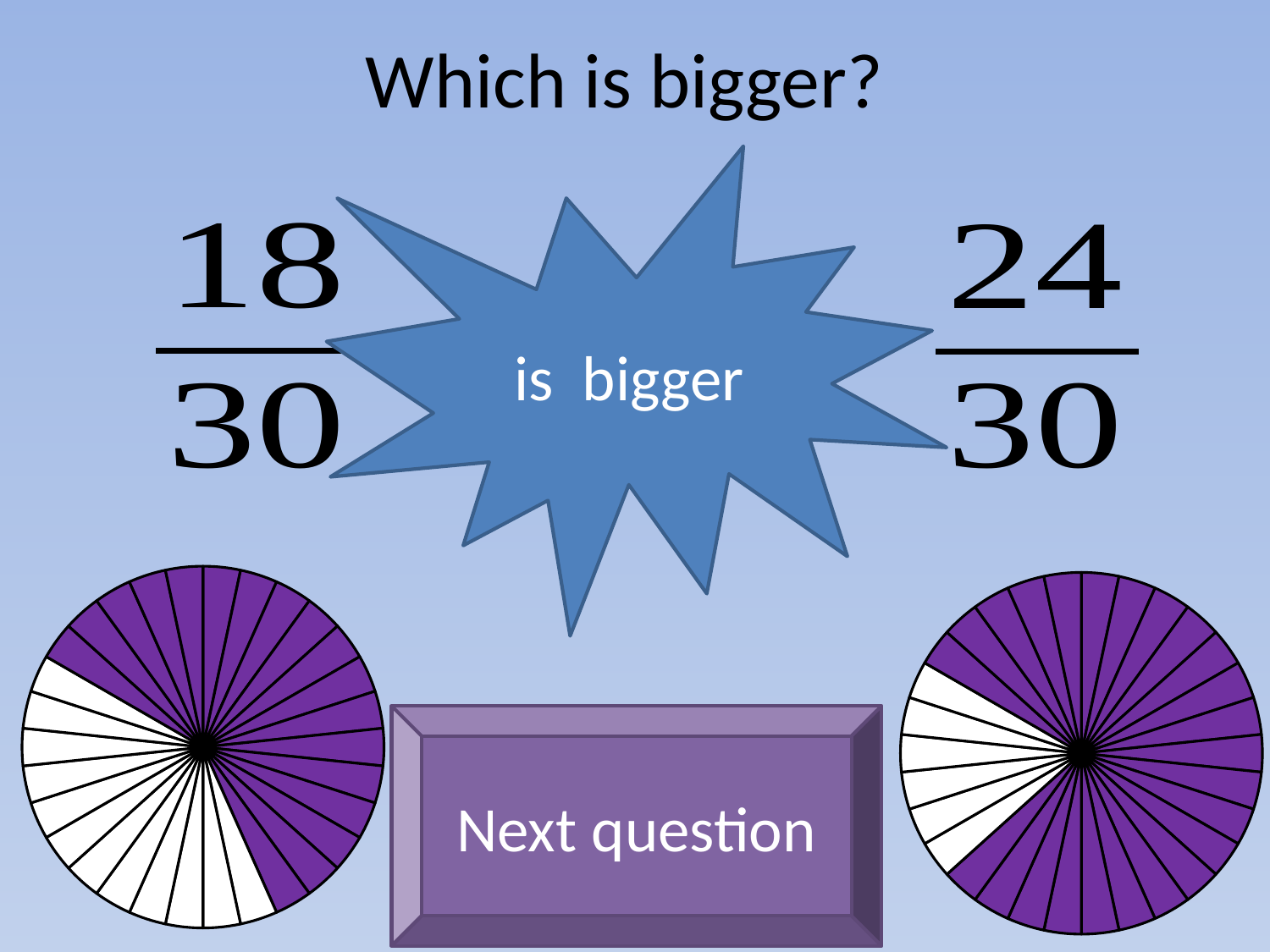
What fraction is shown above the left pie chart? 18/30 How many segments of the left pie chart are shaded purple? 18 How many segments of the left pie chart are left white (unshaded)? 12 What fraction is shown above the right pie chart? 24/30 How many segments of the right pie chart are left white (unshaded)? 6 How many equal segments is the right pie chart divided into? 30 How many equal segments is the left pie chart divided into? 30 What colour is used for the shaded segments in both pie charts? purple How many segments of the right pie chart are shaded purple? 24 How many more segments are shaded purple in the right pie chart than in the left pie chart? 6 Which pie chart has the larger purple shaded share, the left one or the right one? the right one What kind of chart is shown at the bottom left of the slide? pie chart